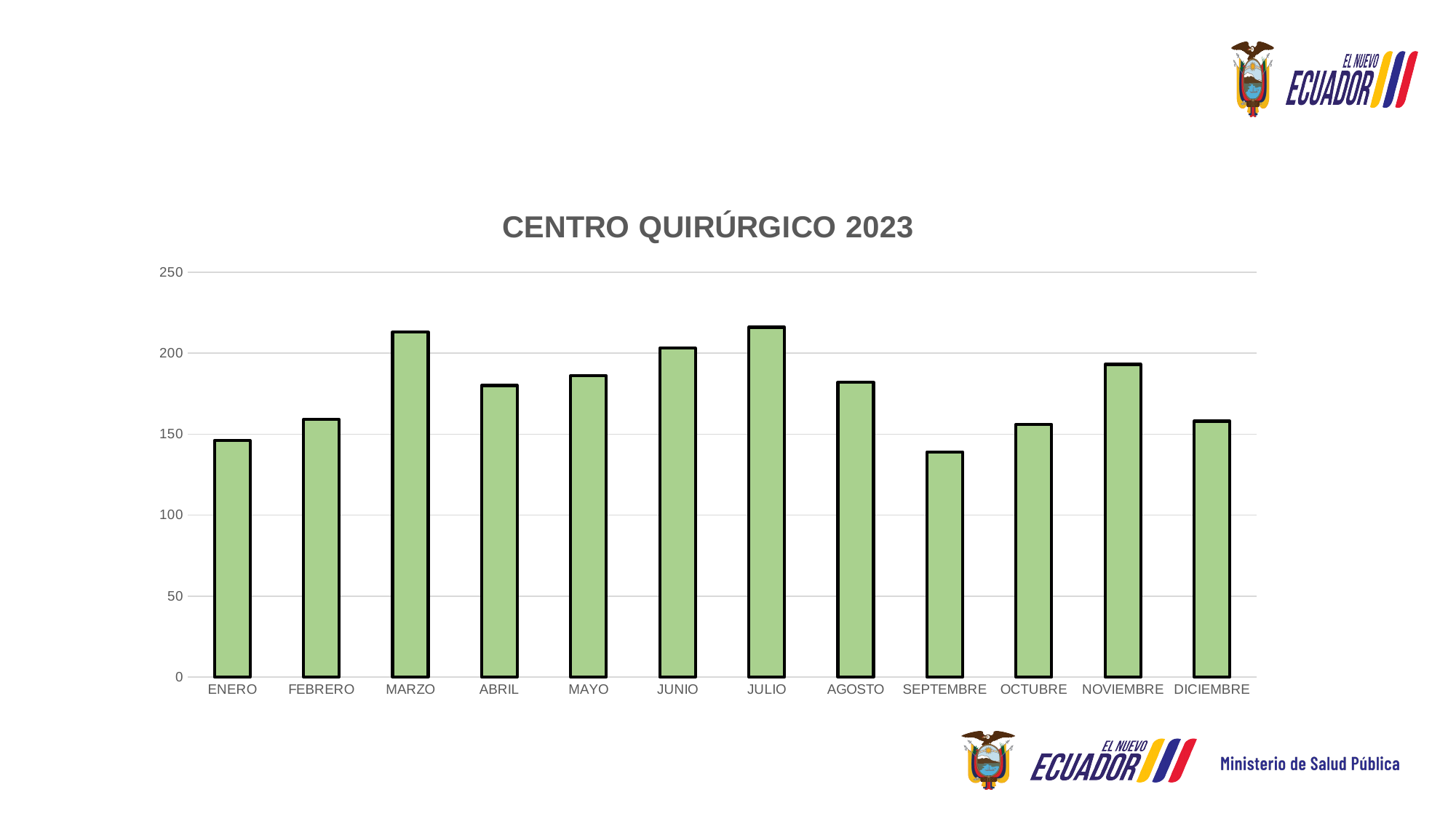
What type of chart is shown on the slide? bar chart Is the value for MARZO greater or less than 200? greater Is the value for NOVIEMBRE greater or less than 200? less What is the title of the chart? CENTRO QUIRÚRGICO 2023 What colour are the bars in the chart? green Which month has the lowest value? SEPTEMBRE Is the value for ENERO greater or less than 150? less How many months (categories) are shown on the x axis? 12 Which is larger, the value for MARZO or the value for ABRIL? MARZO Which is larger, the value for NOVIEMBRE or the value for DICIEMBRE? NOVIEMBRE